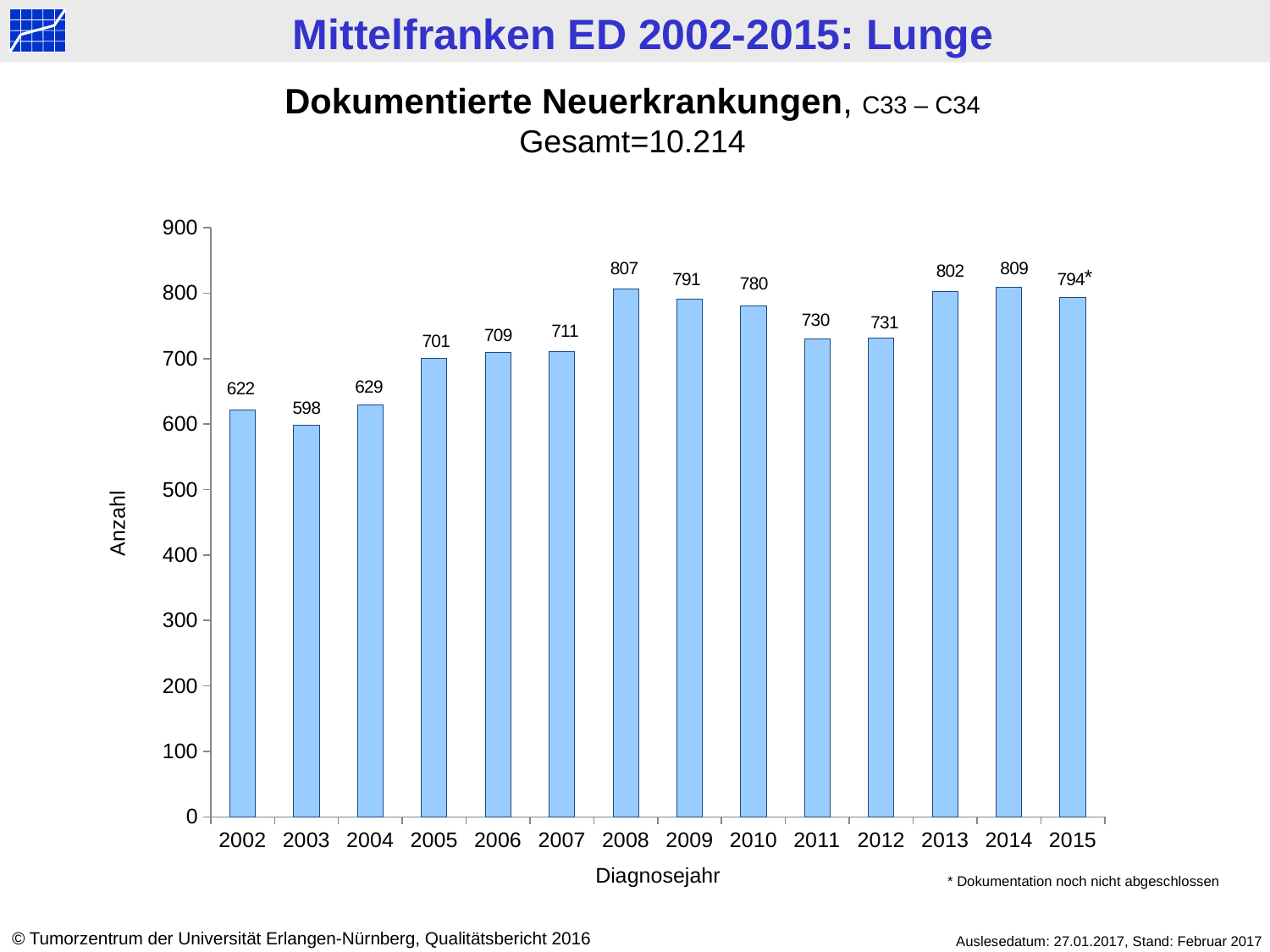
What is the value for 2015? 794 What is the value for 2003? 598 Which year has the lowest value? 2003 Which is larger, the value for 2011 or the value for 2012? 2012 How many years are shown on the x axis? 14 Do the values rise or fall from 2002 to 2008? rise What is the label of the y axis? Anzahl What kind of chart is shown? bar chart What is the difference between the values for 2014 and 2003? 211 Is the value for 2005 greater or less than 600? greater Which year has the highest value? 2014 What is the value for 2008? 807